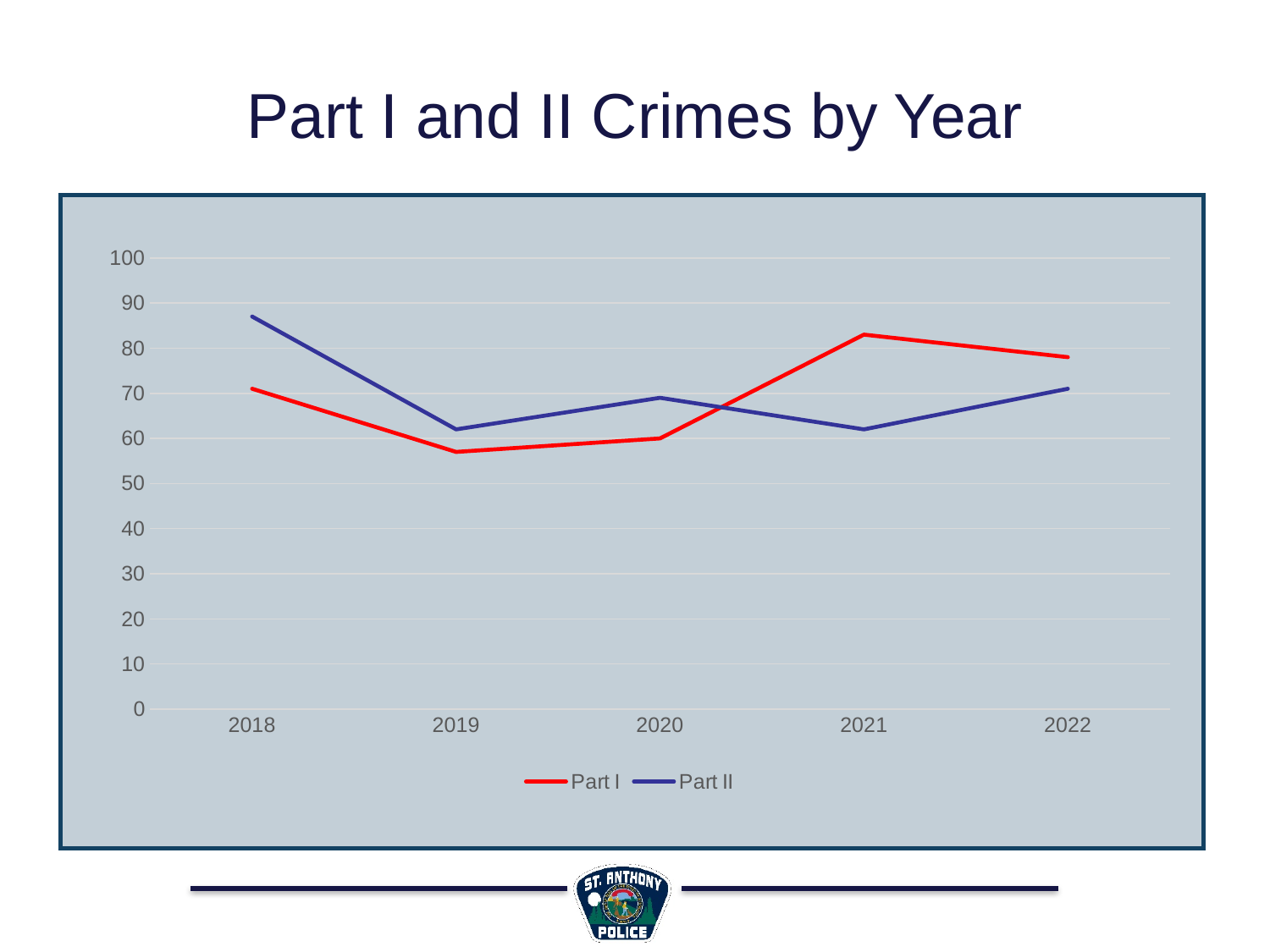
How many series does the legend list? 2 Does the Part I line rise or fall from 2018 to 2019? fall In which year is the Part I line at its highest? 2021 In which year is the Part I line at its lowest? 2019 Is the value for Part I in 2019 greater or less than 60? less In which year is the Part II line at its highest? 2018 Is the value for Part II in 2018 greater or less than 80? greater In 2021, which series has the larger value, Part I or Part II? Part I What kind of chart is shown on the slide? line chart In 2018, which series has the larger value, Part I or Part II? Part II How many years are plotted along the x axis? 5 Is the value for Part I in 2021 greater or less than 80? greater